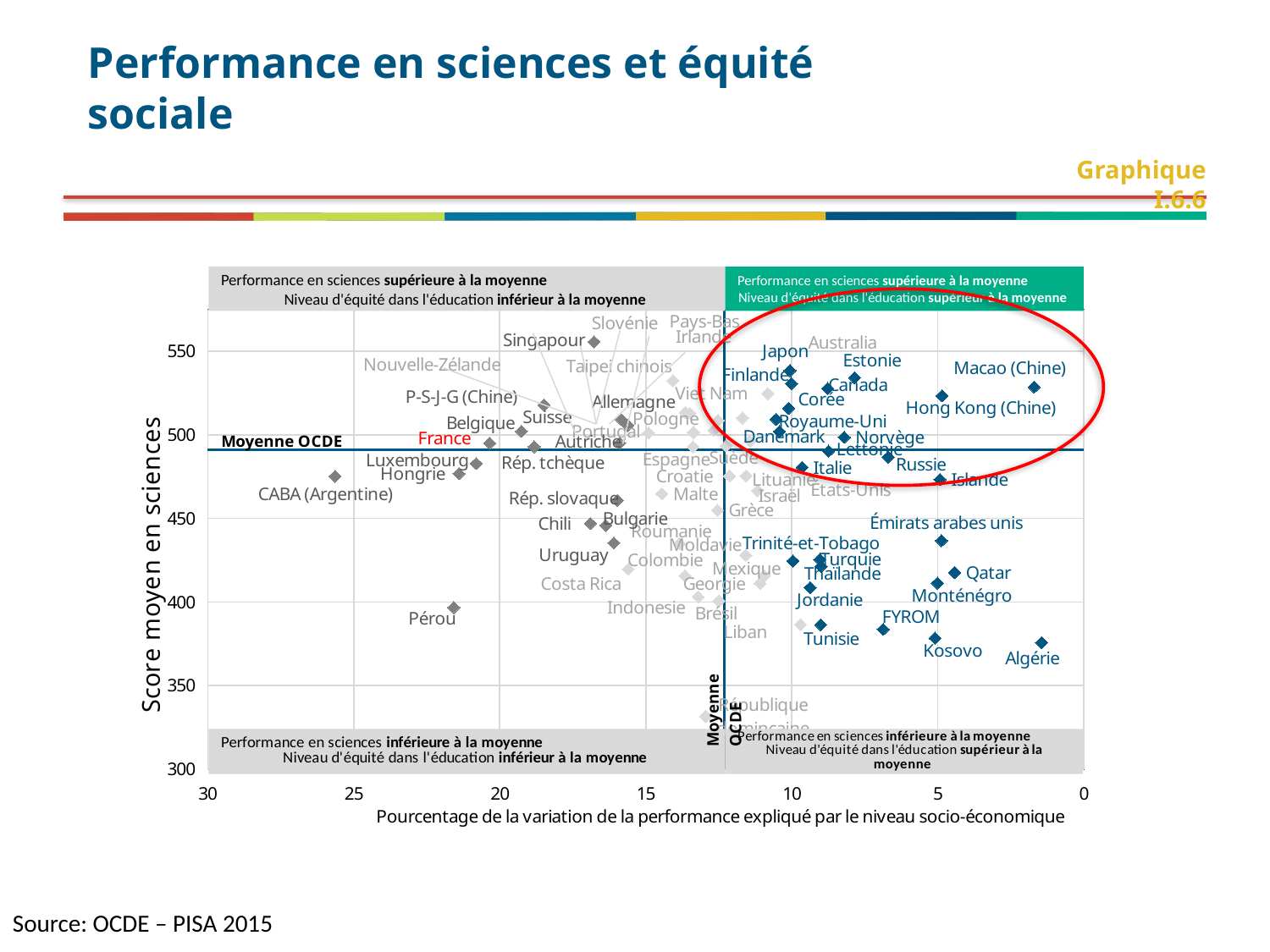
Which country has the highest science score on the chart? Singapour Is the science score for Macao (Chine) greater or less than 500? greater Is the science score for Qatar greater or less than 450? less What kind of chart is shown on the slide? scatter plot What is the title of the chart on the slide? Performance en sciences et équité sociale Is the percentage of variation explained by socio-economic level for CABA (Argentine) greater or less than 20? greater What is the label of the vertical axis? Score moyen en sciences Which country has the higher science score, Japon or Tunisie? Japon